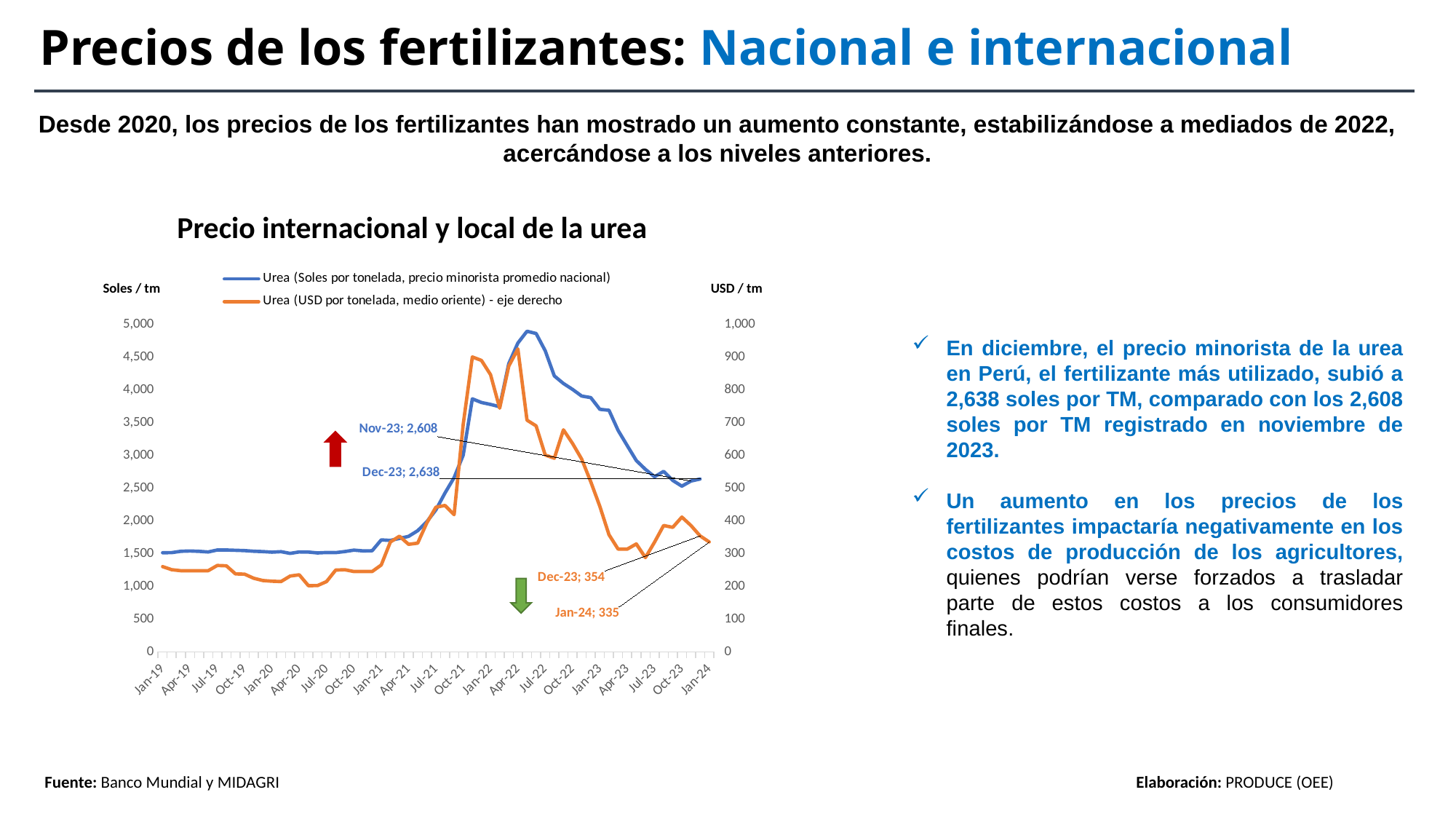
Which is larger for the Urea (USD por tonelada) series: the Dec-23 value or the Jan-24 value? Dec-23 Does the Urea (Soles por tonelada) series rise or fall between Apr-22 and Jan-24? Fall What is the value of the Urea (USD por tonelada, medio oriente) series at Jan-24? 335 What is the value of the Urea (Soles por tonelada) series at Nov-23? 2,608 Is the peak value of the Urea (Soles por tonelada) series around Apr-22 greater or less than 4,500? greater What is the title of the chart? Precio internacional y local de la urea What is the difference between the Dec-23 and Jan-24 values of the Urea (USD por tonelada) series? 19 What is the value of the Urea (Soles por tonelada) series at Dec-23? 2,638 How many series does the legend list? 2 What kind of chart is shown on the slide? Line chart By how much did the Urea (Soles por tonelada) value change from Nov-23 to Dec-23? 30 What is the value of the Urea (USD por tonelada, medio oriente) series at Dec-23? 354